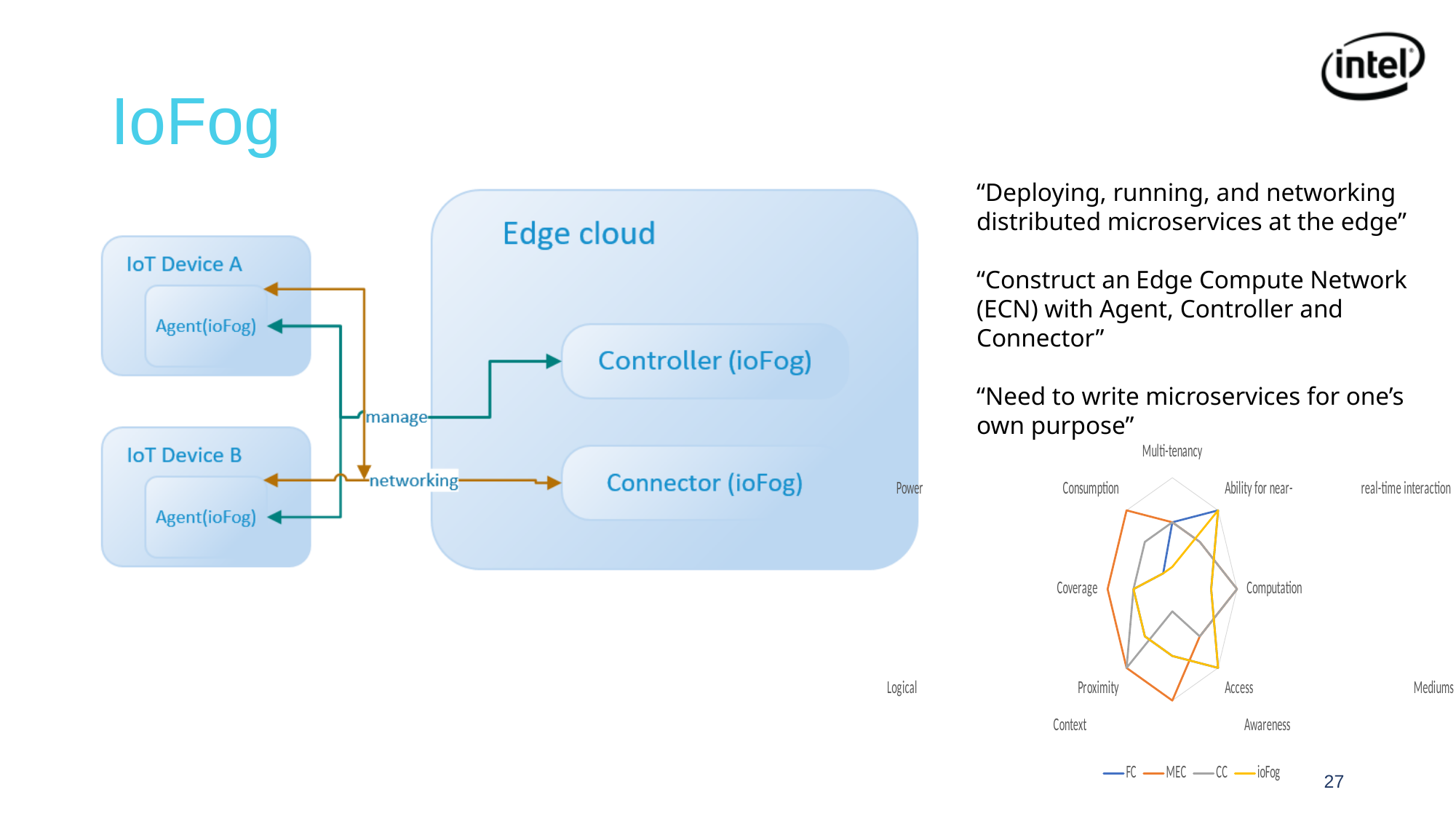
On the radar chart, which series extends further along the Coverage axis, MEC or ioFog? MEC What kind of chart is shown at the bottom right of the slide? radar chart How many axes (categories) does the radar chart have? 8 What colour is the ioFog series drawn in on the radar chart? yellow Which series are listed in the legend of the radar chart? FC, MEC, CC, ioFog On the radar chart, which series extends furthest along the Context Awareness axis? MEC How many series does the legend of the radar chart list? 4 On the radar chart, which series extends furthest along the Coverage axis? MEC